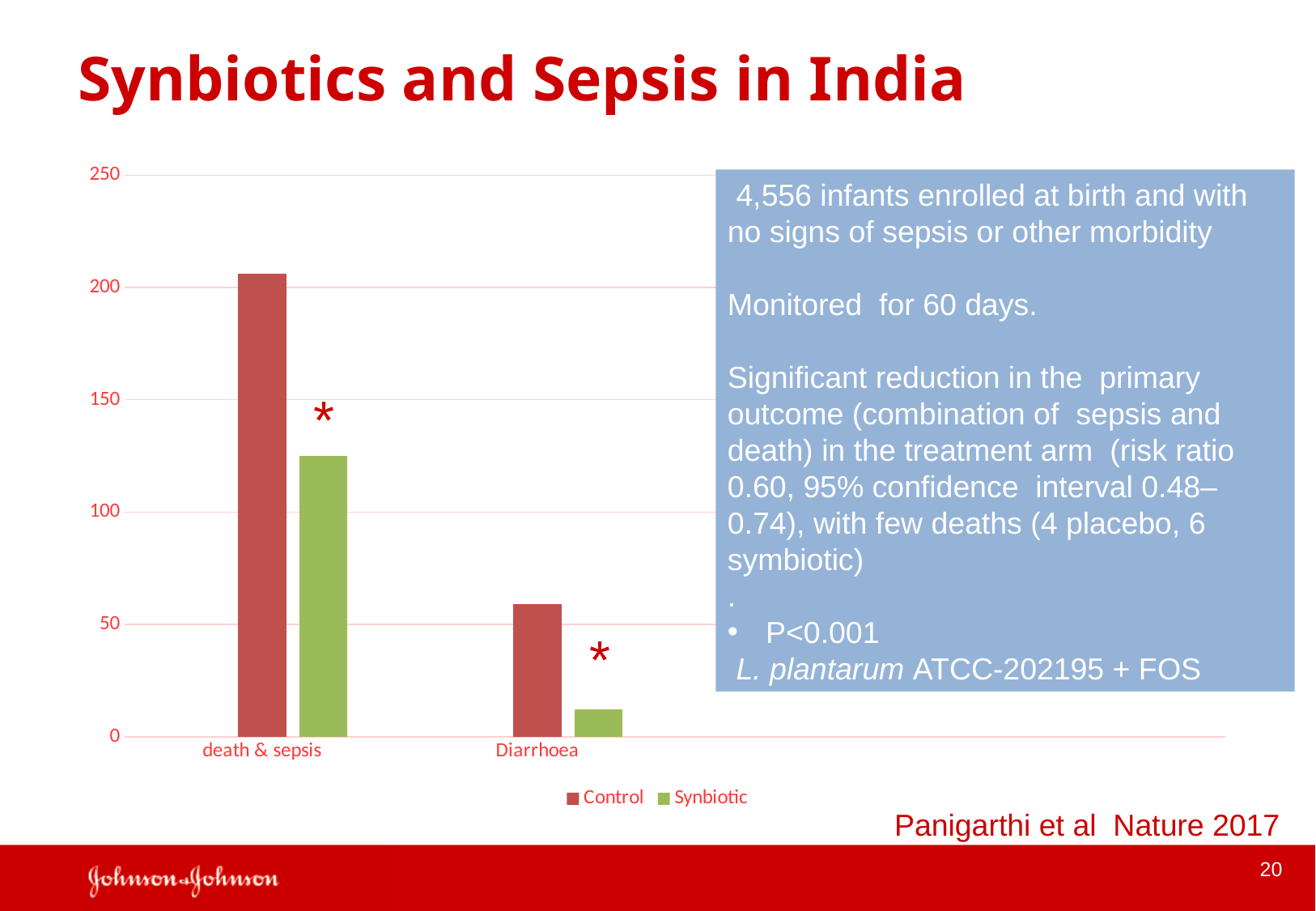
Which bar in the chart is the shortest? Synbiotic, Diarrhoea For death & sepsis, which series has the larger value, Control or Synbiotic? Control What are the two series named in the chart legend? Control and Synbiotic Is the Control value for death & sepsis greater or less than 200? greater Which bar in the chart is the tallest? Control, death & sepsis How many series does the chart legend list? 2 Is the Synbiotic value for death & sepsis greater or less than 150? less How many categories are shown on the x axis of the chart? 2 For Diarrhoea, which series has the larger value, Control or Synbiotic? Control Do the Control values rise or fall from death & sepsis to Diarrhoea? fall What kind of chart is shown on the slide? bar chart Is the Synbiotic value for Diarrhoea greater or less than 50? less